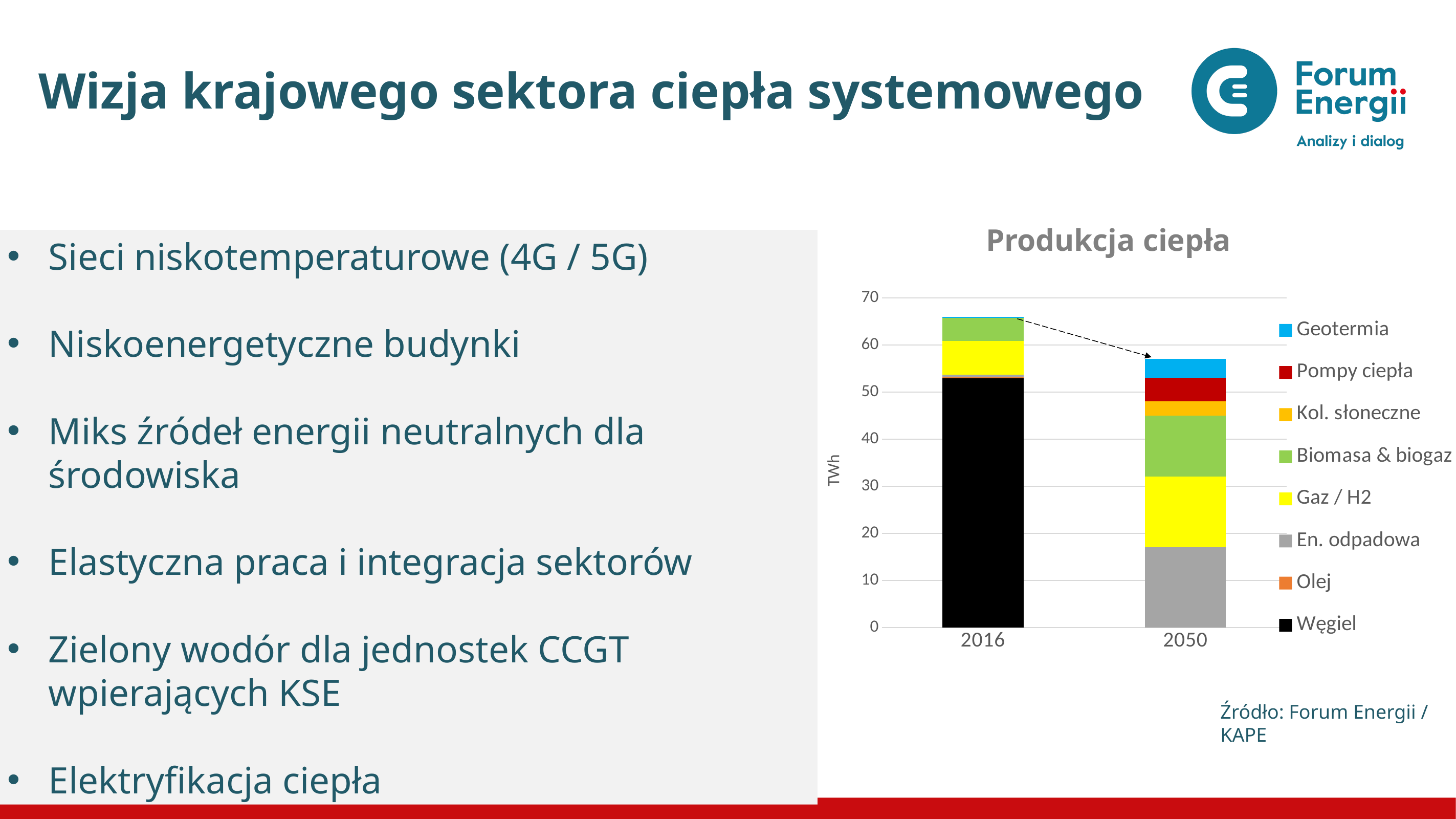
Is the total heat production for 2016 greater or less than 60 TWh? greater How many years (categories) are plotted on the x axis of the "Produkcja ciepła" chart? 2 What kind of chart is shown under the title "Produkcja ciepła"? stacked bar chart Does total heat production rise or fall from 2016 to 2050? fall Which year has the higher total heat production, 2016 or 2050? 2016 Is the value for Węgiel in 2016 greater or less than 50 TWh? greater Which series appears at the top of the 2050 stacked bar? Geotermia How many series does the legend of the "Produkcja ciepła" chart list? 8 What unit is shown on the y axis of the "Produkcja ciepła" chart? TWh Which energy source makes up the largest part of the 2016 bar? Węgiel Is the value for En. odpadowa in 2050 greater or less than 10 TWh? greater